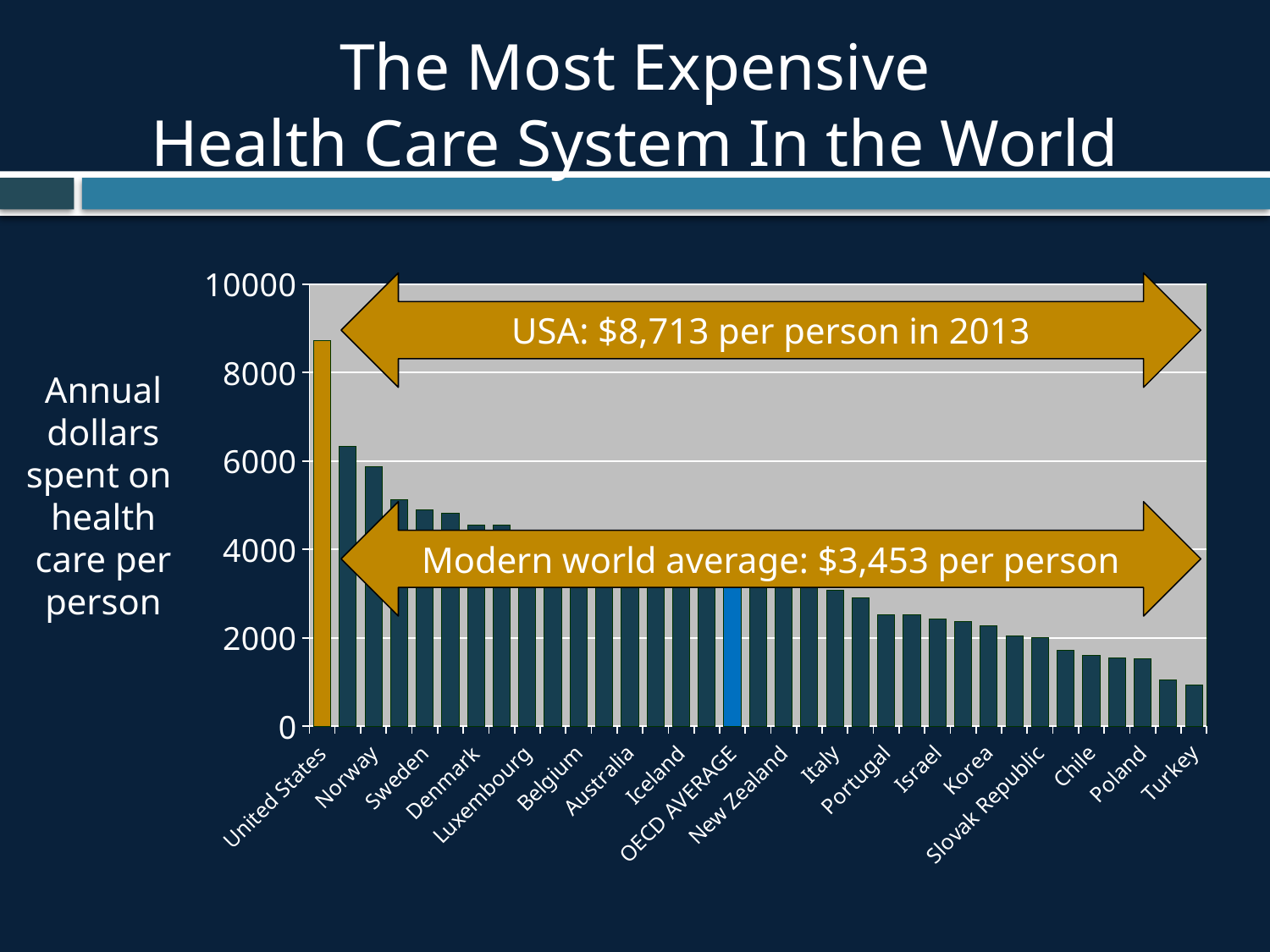
Do the bar values generally rise or fall from left to right along the x axis? fall Which country has the highest annual health care spending per person? United States What is the title of the slide containing the chart? The Most Expensive Health Care System In the World Is the value for Korea greater or less than 4000? less According to the slide, how much did the USA spend per person on health care in 2013? $8,713 What is the modern world average health care spending per person stated on the slide? $3,453 Which country has the lowest annual health care spending per person? Turkey Is the value for Norway greater or less than 6000? less Is the value for Poland greater or less than 2000? less What kind of chart is shown on the slide? bar chart Which has a higher value, Norway or Sweden? Norway